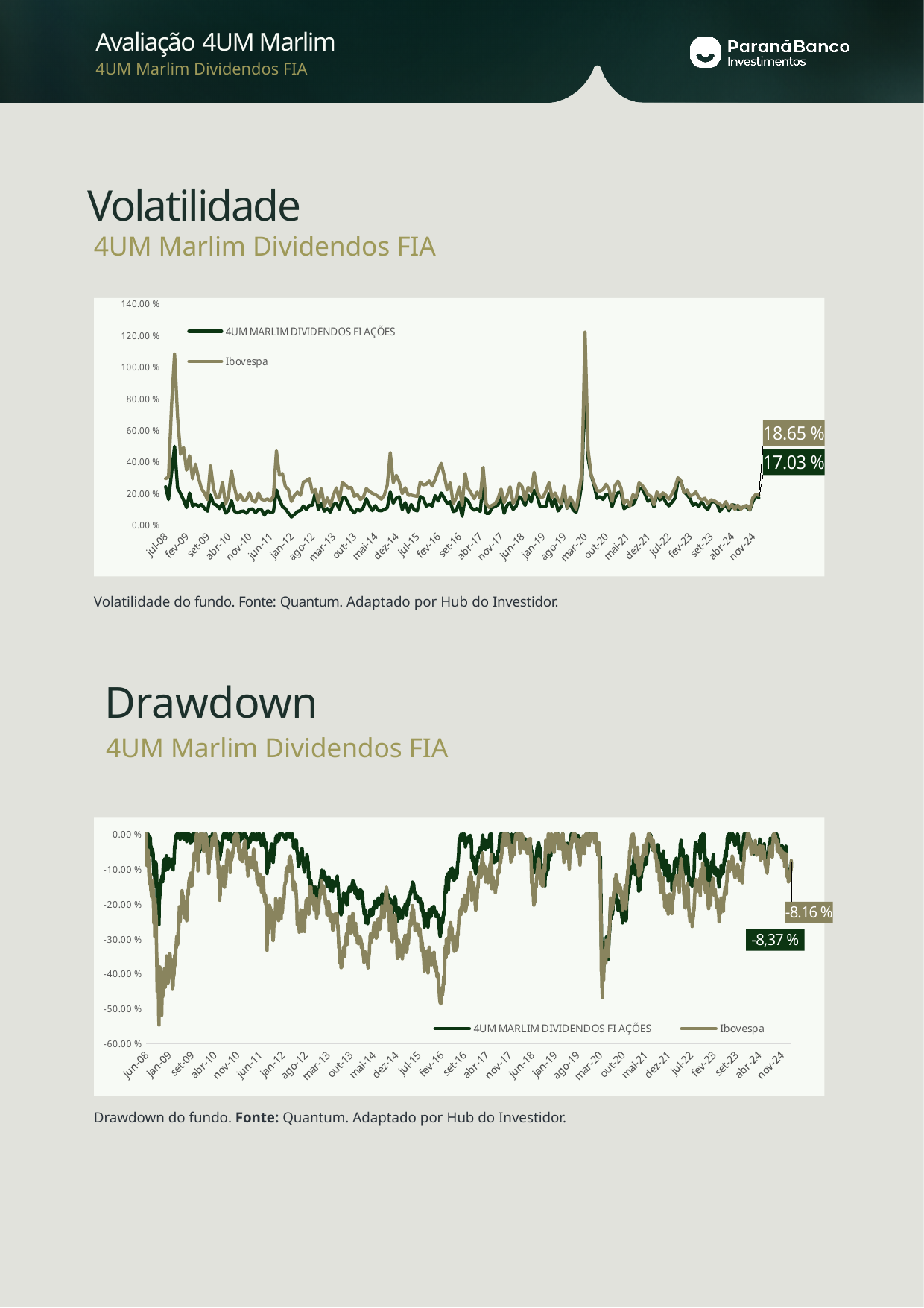
On the Volatilidade chart, what is the latest labelled value for 4UM MARLIM DIVIDENDOS FI AÇÕES? 17.03 % What kind of chart is the Drawdown chart? Line chart How many series does the legend of the Volatilidade chart list? 2 On the Volatilidade chart, which series has the higher latest labelled value, Ibovespa or 4UM MARLIM DIVIDENDOS FI AÇÕES? Ibovespa On the Volatilidade chart, what is the latest labelled value for Ibovespa? 18.65 % On the Volatilidade chart, is the peak of the Ibovespa line around mar-20 greater or less than 100.00 %? greater On the Drawdown chart, what is the latest labelled value for 4UM MARLIM DIVIDENDOS FI AÇÕES? -8,37 % On the Volatilidade chart, what is the difference between the latest labelled Ibovespa value and the latest labelled fund value? 1.62 % What is the source cited below the Volatilidade chart? Quantum On the Drawdown chart, is the lowest point of the Ibovespa line around jan-09 greater or less than -50.00 %? less On the Drawdown chart, which series reaches the deeper drawdown around mar-20, Ibovespa or 4UM MARLIM DIVIDENDOS FI AÇÕES? Ibovespa On the Drawdown chart, what is the latest labelled value for Ibovespa? -8.16 %